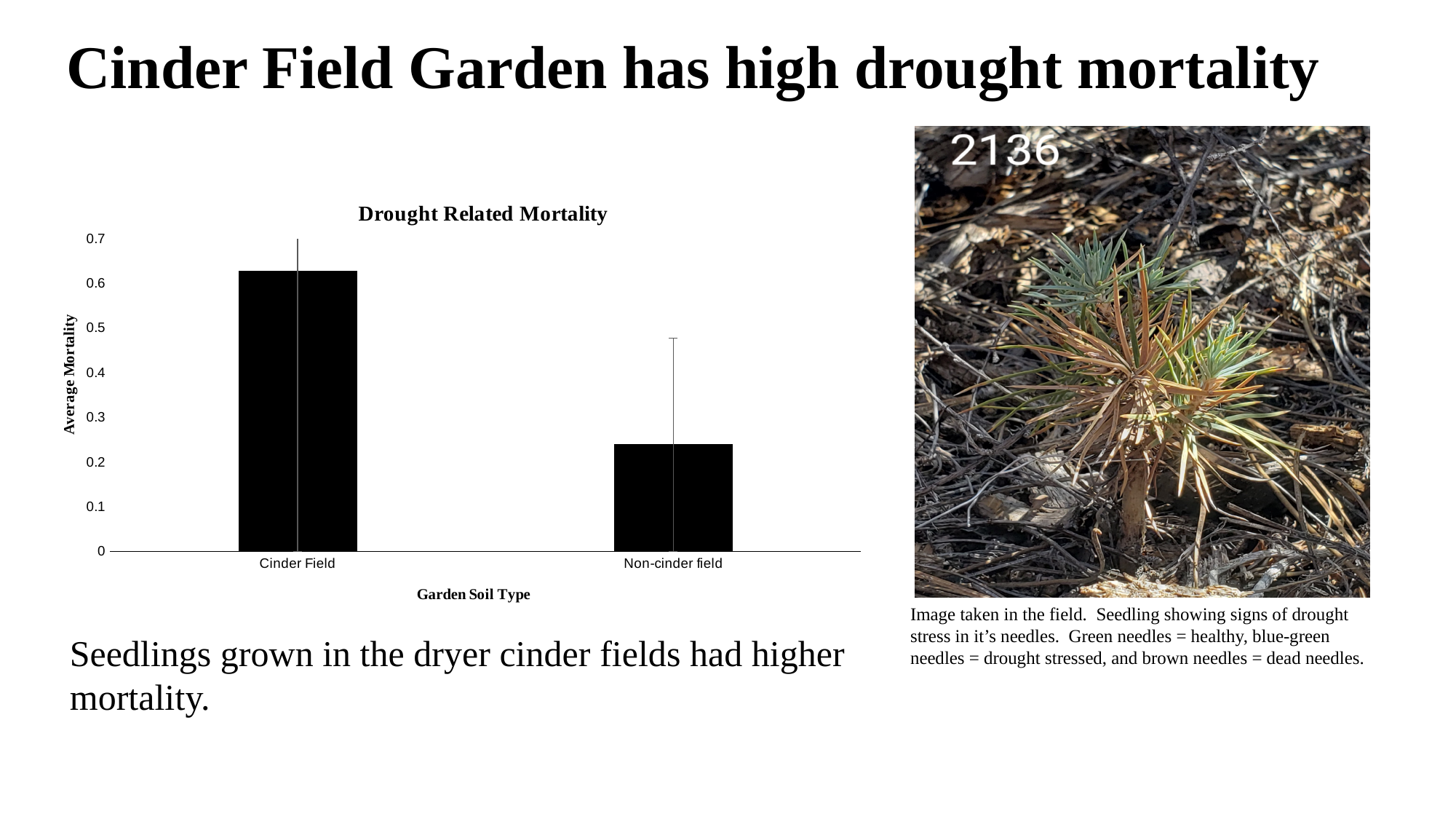
What is the title of the chart? Drought Related Mortality Is the value for Non-cinder field greater or less than 0.5? less Which garden soil type has the lowest average mortality? Non-cinder field Which garden soil type has the highest average mortality? Cinder Field Is the value for Non-cinder field greater or less than 0.3? less What kind of chart is shown on the slide? bar chart What is the label of the y axis of the chart? Average Mortality Which has a larger average mortality, Cinder Field or Non-cinder field? Cinder Field Do the bar values rise or fall from Cinder Field to Non-cinder field along the x axis? fall Is the value for Cinder Field greater or less than 0.5? greater How many categories are plotted on the x axis of the chart? 2